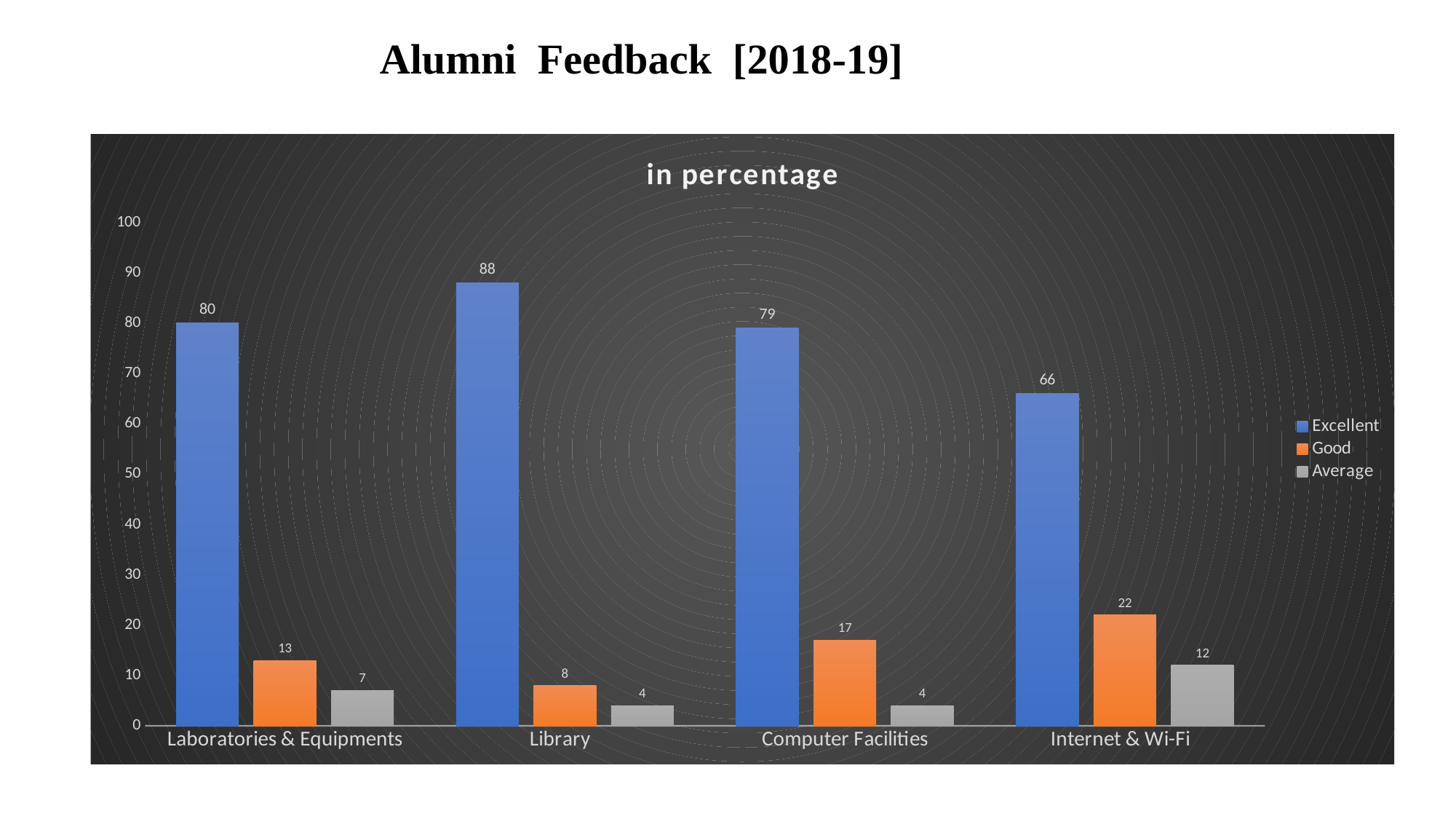
Which category has the highest Excellent value? Library What kind of chart is shown on the slide? Bar chart How many series does the legend list? 3 What is the difference between the Excellent values for Library and Internet & Wi-Fi? 22 Which is larger, the Good value for Laboratories & Equipments or the Good value for Computer Facilities? Computer Facilities What is the Good value for Internet & Wi-Fi? 22 How many categories are shown on the x axis? 4 What is the Average value for Computer Facilities? 4 What is the Excellent value for Library? 88 What is the title shown inside the chart area? in percentage Which category has the lowest Excellent value? Internet & Wi-Fi Is the Excellent value for Computer Facilities greater or less than 70? greater